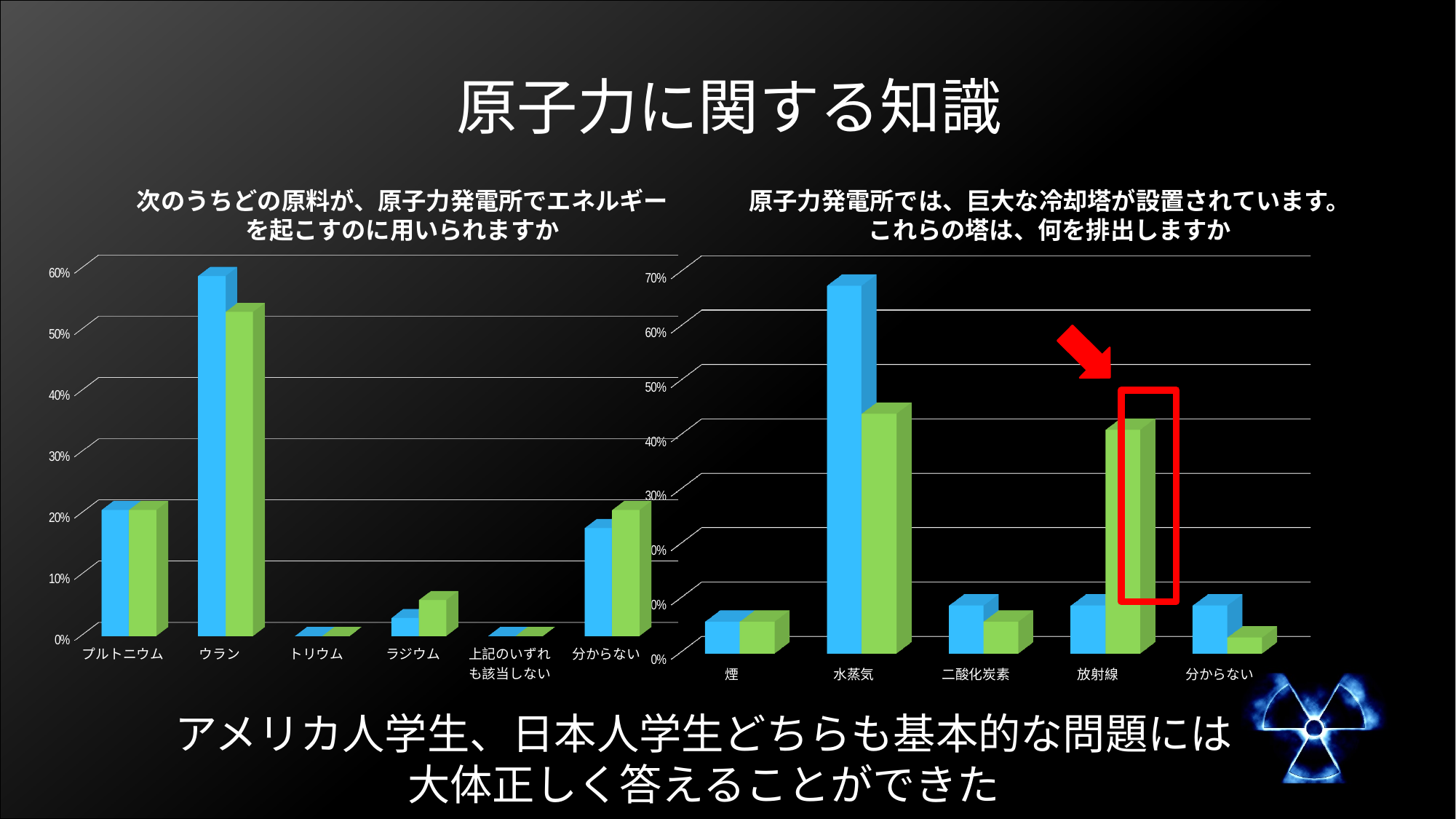
In the right chart (原子力発電所では…), which is larger for 放射線, the blue bar or the green bar? The green bar How many categories are shown on the x axis of the right chart (原子力発電所では、巨大な冷却塔が設置されています…)? 5 In the left chart (次のうちどの原料が…), which category has the highest bars? ウラン In the right chart (原子力発電所では…), is the green bar for 放射線 greater or less than 30%? greater In the left chart (次のうちどの原料が…), is the blue bar for ウラン greater or less than 50%? greater In the right chart (原子力発電所では…), which category has the highest bar? 水蒸気 What kind of chart is the left chart (次のうちどの原料が、原子力発電所でエネルギーを起こすのに用いられますか)? Bar chart In the right chart (原子力発電所では…), is the blue bar for 水蒸気 greater or less than 60%? greater In the right chart (原子力発電所では…), which category is highlighted with a red box and red arrow? 放射線 How many categories are shown on the x axis of the left chart (次のうちどの原料が…)? 6 In the left chart (次のうちどの原料が…), which is larger for ウラン, the blue bar or the green bar? The blue bar In the left chart (次のうちどの原料が…), which category has the lowest bars? トリウム and 上記のいずれも該当しない (both at 0%)